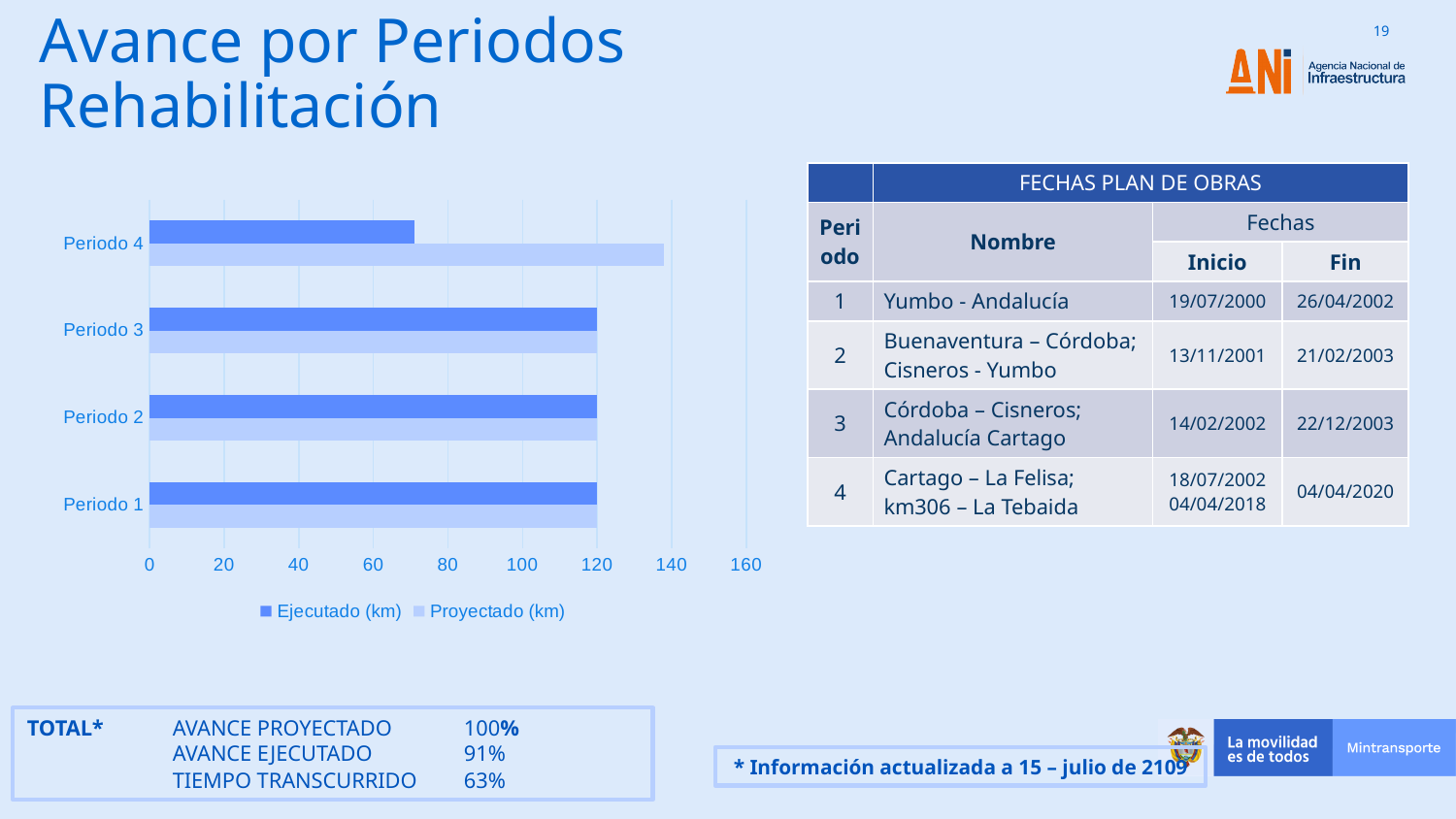
Which period has the lowest Ejecutado (km) value in the bar chart? Periodo 4 Is the Proyectado (km) value for Periodo 4 greater or less than 120? greater Is the Ejecutado (km) value for Periodo 4 greater or less than 80? less What are the two series named in the bar chart's legend? Ejecutado (km) and Proyectado (km) Is the Ejecutado (km) value for Periodo 4 greater or less than 60? greater How many periods (categories) does the bar chart show? 4 How many series does the bar chart's legend list? 2 What kind of chart is shown on the left of the slide? bar chart For Periodo 4, which is larger: Ejecutado (km) or Proyectado (km)? Proyectado (km) Which period has the highest Proyectado (km) value in the bar chart? Periodo 4